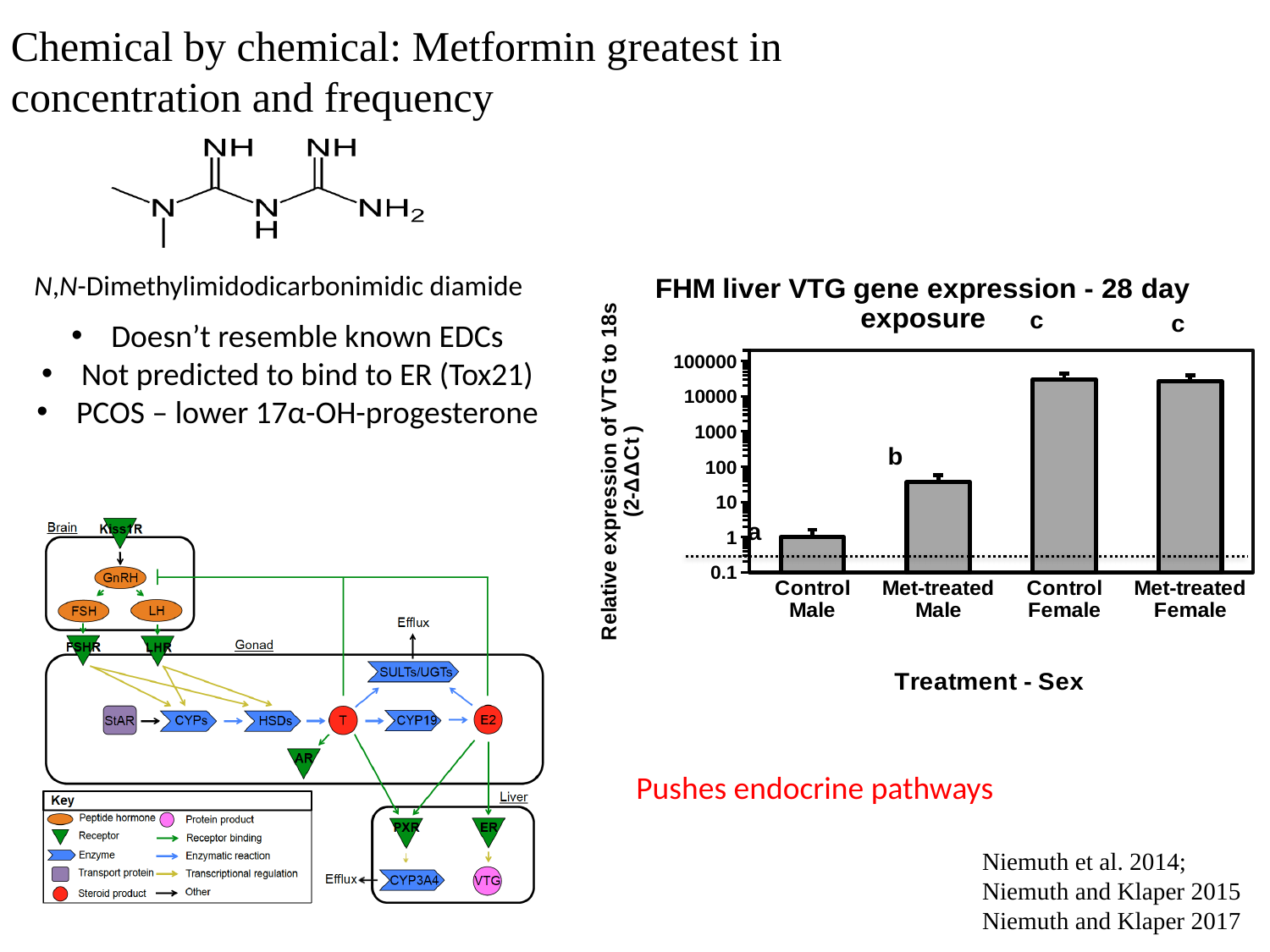
What letter is printed above the Met-treated Male bar in the chart? b Which has higher relative VTG expression, Met-treated Male or Control Male? Met-treated Male Is the relative VTG expression for Met-treated Male greater or less than 10? greater Which category has the lowest relative VTG expression in the chart? Control Male Which has higher relative VTG expression, Control Female or Met-treated Male? Control Female Is the relative VTG expression for Met-treated Male greater or less than 100? less Is the relative VTG expression for Control Male greater or less than 10? less How many treatment-sex categories are shown on the x axis of the VTG gene expression chart? 4 What is the x-axis title of the VTG gene expression chart? Treatment - Sex What kind of chart is the 'FHM liver VTG gene expression - 28 day exposure' chart? bar chart